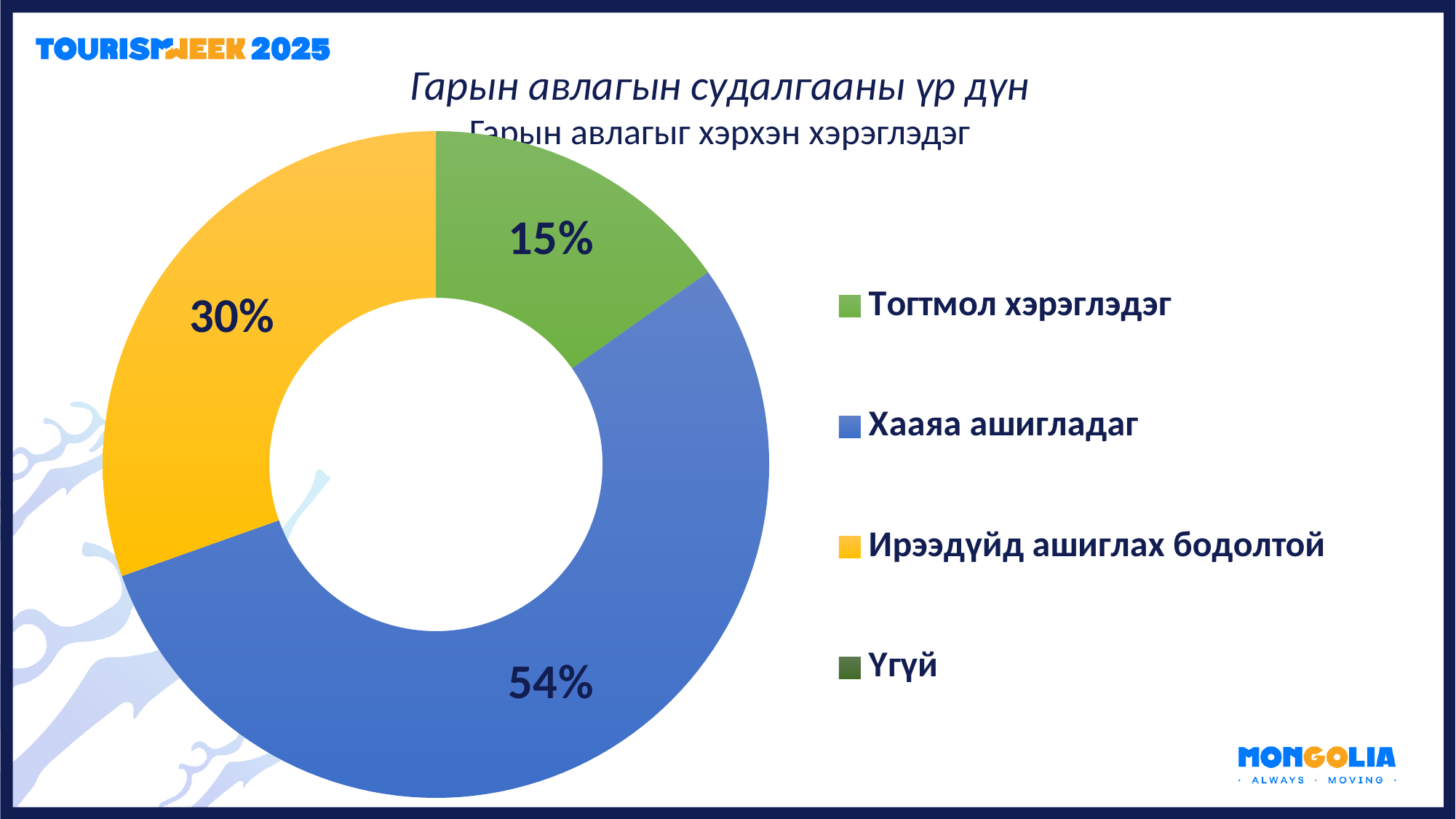
How many entries does the chart legend list? 4 Which category has the largest share of the chart? Хааяа ашигладаг What colour represents Хааяа ашигладаг in the chart? Blue What percentage is shown for Тогтмол хэрэглэдэг? 15% Which is larger, the share for Ирээдүйд ашиглах бодолтой or the share for Тогтмол хэрэглэдэг? Ирээдүйд ашиглах бодолтой What percentage is shown for Хааяа ашигладаг? 54% What is the difference in percentage points between Хааяа ашигладаг and Тогтмол хэрэглэдэг? 39 What kind of chart is shown on the slide? Doughnut (pie) chart What is the subtitle of the chart, shown below the main title? Гарын авлагыг хэрхэн хэрэглэдэг What is the difference in percentage points between Хааяа ашигладаг and Ирээдүйд ашиглах бодолтой? 24 What percentage is shown for Ирээдүйд ашиглах бодолтой? 30% Is the share for Хааяа ашигладаг greater or less than 50%? greater